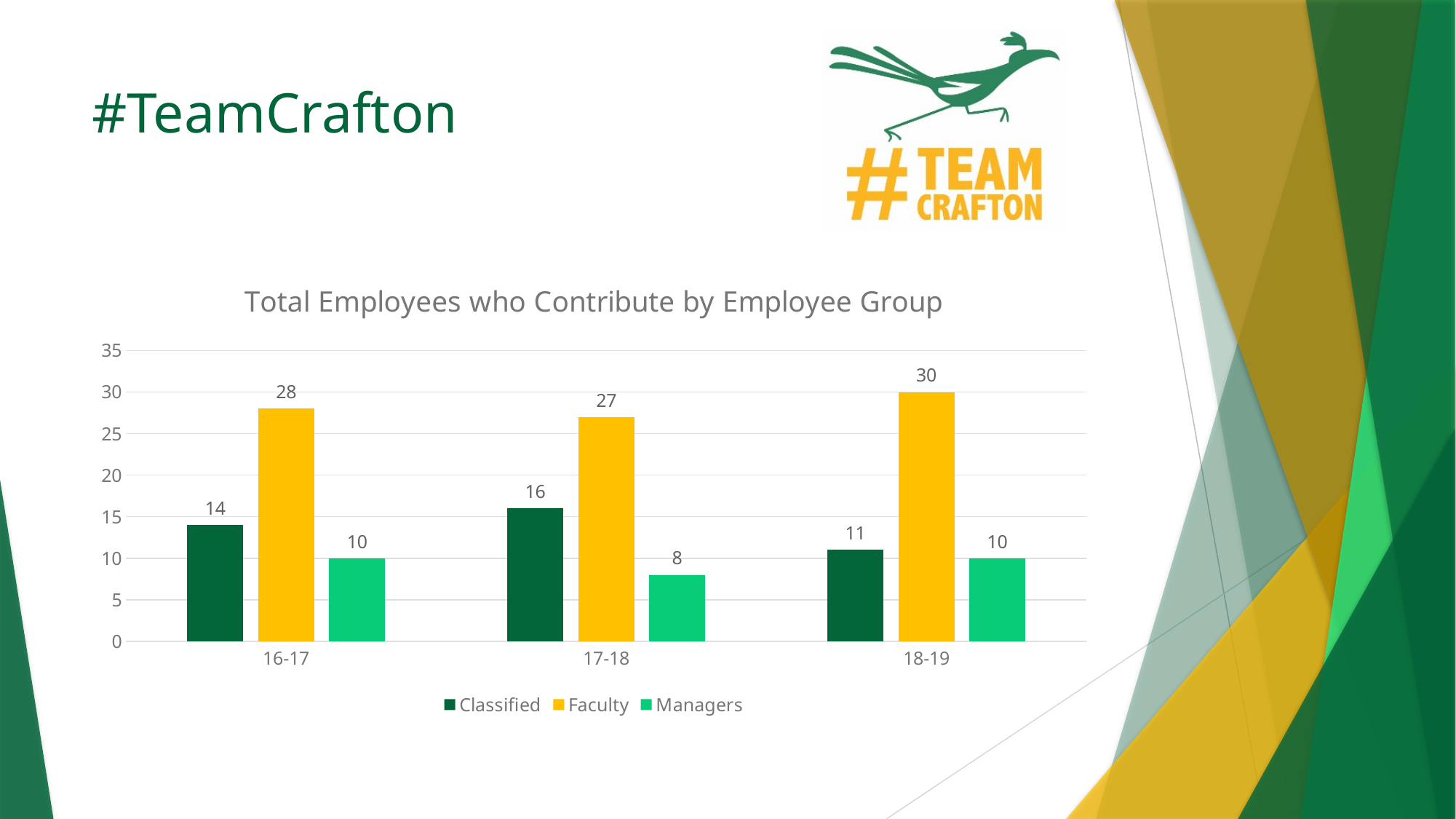
What is the title of the chart? Total Employees who Contribute by Employee Group What is the value for Faculty in 16-17? 28 How many year groups are shown on the x axis? 3 What is the value for Classified in 17-18? 16 What is the value for Managers in 18-19? 10 In which year group is the Faculty value highest? 18-19 What is the difference between the Faculty and Classified values in 18-19? 19 How many series does the legend list? 3 Which is larger, the Classified value in 16-17 or the Classified value in 18-19? 16-17 What kind of chart is shown on the slide? bar chart In which year group is the Managers value lowest? 17-18 Does the Classified value rise or fall from 17-18 to 18-19? fall